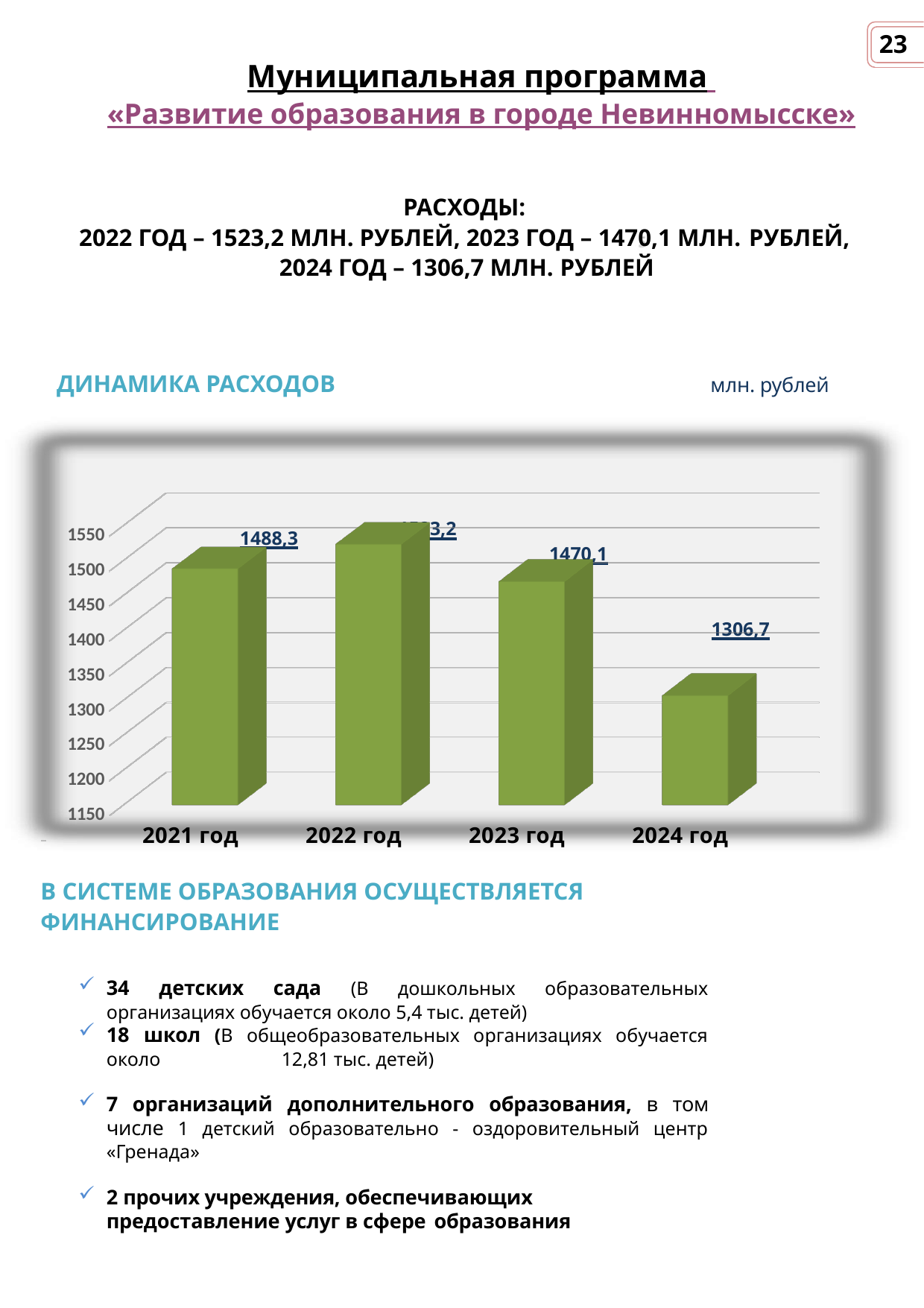
What is the value for 2023 год in the ДИНАМИКА РАСХОДОВ chart? 1470,1 What is the value for 2022 год in the ДИНАМИКА РАСХОДОВ chart? 1523,2 What kind of chart is the ДИНАМИКА РАСХОДОВ chart? bar chart What is the difference between the values for 2021 год and 2023 год in the ДИНАМИКА РАСХОДОВ chart? 18,2 What is the value for 2024 год in the ДИНАМИКА РАСХОДОВ chart? 1306,7 What is the value for 2021 год in the ДИНАМИКА РАСХОДОВ chart? 1488,3 How many years are shown in the ДИНАМИКА РАСХОДОВ chart? 4 Which is larger in the ДИНАМИКА РАСХОДОВ chart: the value for 2021 год or 2023 год? 2021 год Is the value for 2024 год in the ДИНАМИКА РАСХОДОВ chart greater or less than 1350? less What is the difference between the values for 2023 год and 2024 год in the ДИНАМИКА РАСХОДОВ chart? 163,4 Which year has the lowest value in the ДИНАМИКА РАСХОДОВ chart? 2024 год Which year has the highest value in the ДИНАМИКА РАСХОДОВ chart? 2022 год